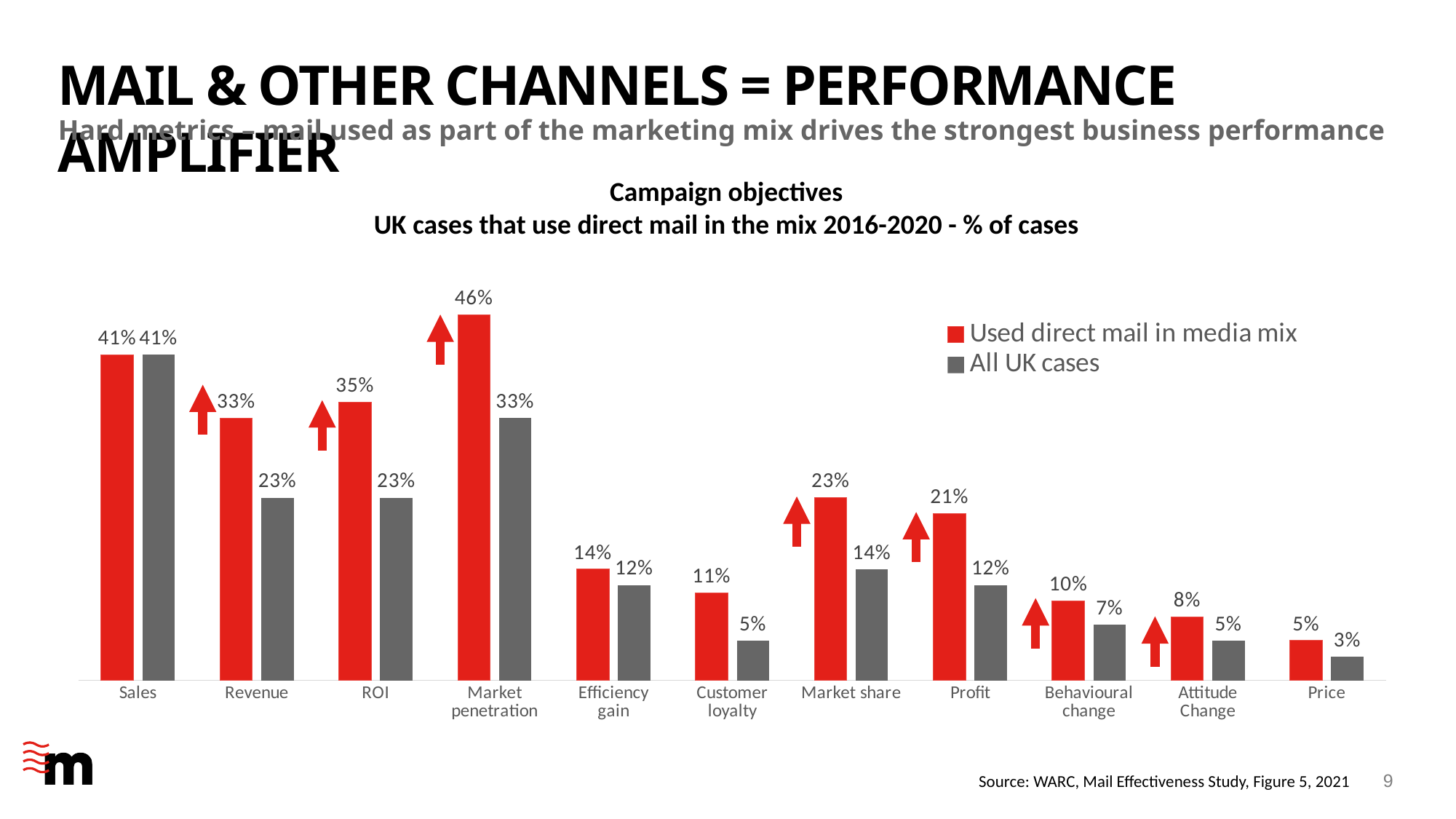
What kind of chart is shown on the slide? Bar chart What percentage of cases that used direct mail in the media mix had Market penetration as an objective? 46% Which campaign objective has the lowest value for All UK cases? Price What is the value for Used direct mail in media mix for Profit? 21% For Market share, which series has the larger value: Used direct mail in media mix or All UK cases? Used direct mail in media mix How many campaign objectives are shown on the x axis? 11 How many series does the legend list? 2 What is the value for All UK cases for Customer loyalty? 5% Which campaign objective has the highest value for Used direct mail in media mix? Market penetration Which colour represents All UK cases in the chart? Grey What is the difference between the two series for Revenue? 10% What is the difference between the Used direct mail in media mix value and the All UK cases value for Market penetration? 13%